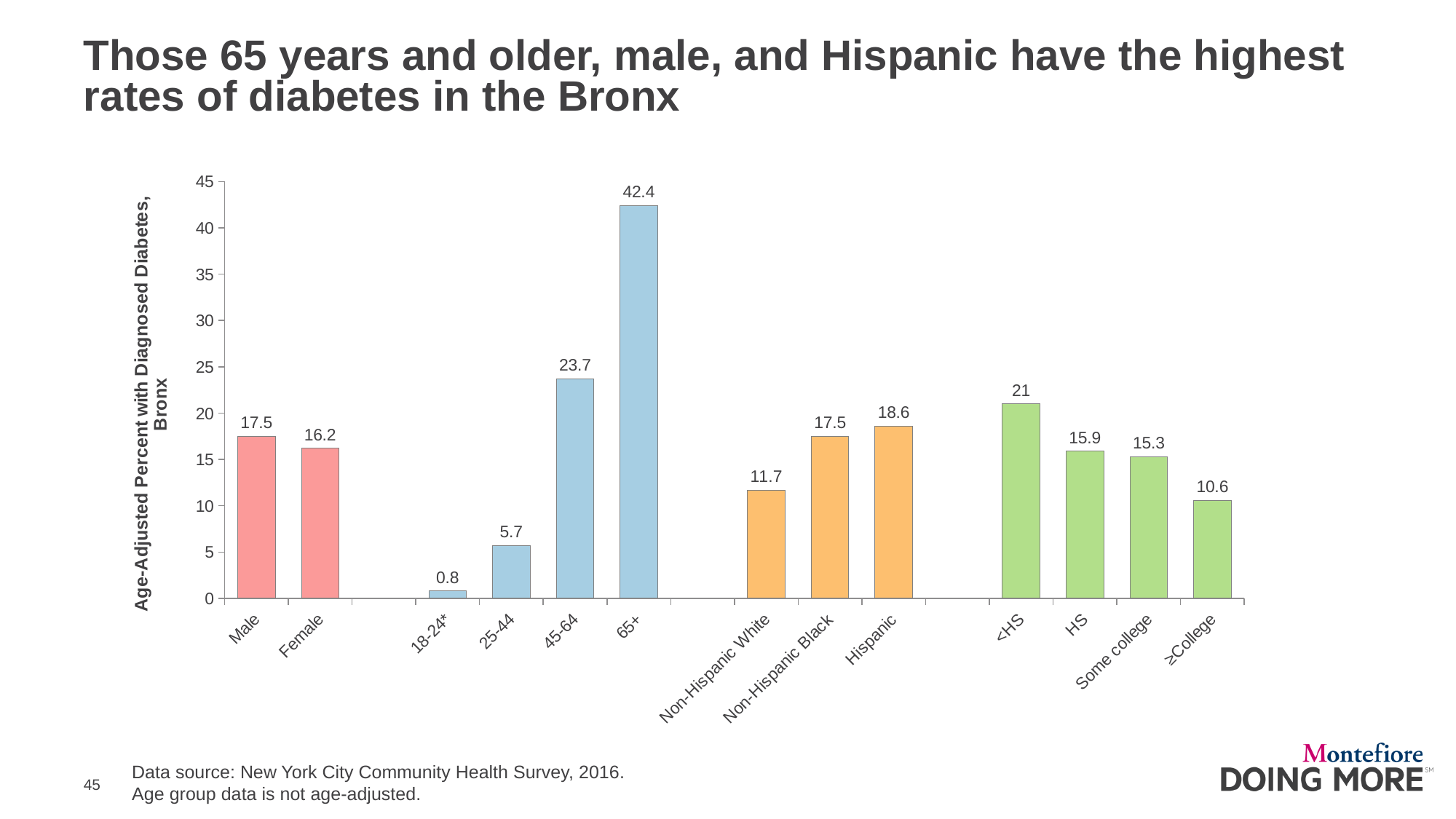
How many bars are plotted on the chart? 13 What is the difference between the values for Male and Female? 1.3 Which is larger, the value for Hispanic or the value for Non-Hispanic Black? Hispanic What is the difference between the values for <HS and ≥College? 10.4 Is the value for 45-64 greater or less than 20? greater What is the value for Some college? 15.3 What kind of chart is shown on the slide? bar chart Which category has the lowest value on the chart? 18-24* What is the value for the 65+ age group? 42.4 Which category has the highest value on the chart? 65+ What is the value for Non-Hispanic White? 11.7 What is the label of the vertical axis? Age-Adjusted Percent with Diagnosed Diabetes, Bronx